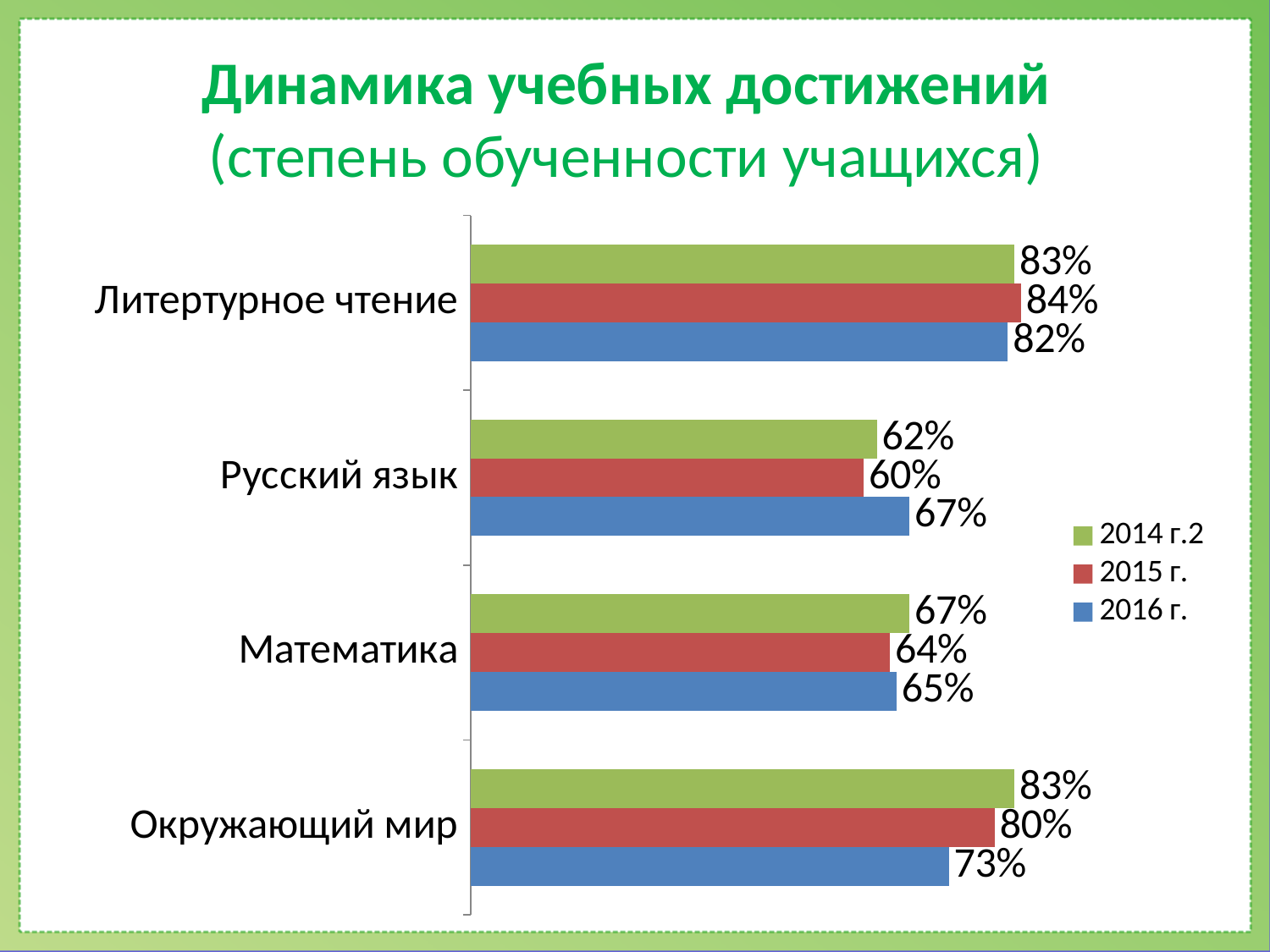
What is the value for Математика in 2014 г.2? 67% What is the difference between the 2014 г.2 and 2016 г. values for Окружающий мир? 10% Which series is shown in blue? 2016 г. How many categories are shown on the chart? 4 What kind of chart is shown on the slide? Bar chart Which category has the highest value in 2015 г.? Литертурное чтение What is the difference between the 2015 г. and 2016 г. values for Литертурное чтение? 2% What is the value for Окружающий мир in 2015 г.? 80% Which is larger for Русский язык: the 2014 г.2 value or the 2015 г. value? 2014 г.2 How many series does the legend list? 3 Which category has the lowest value in 2016 г.? Математика What is the value for Русский язык in 2016 г.? 67%